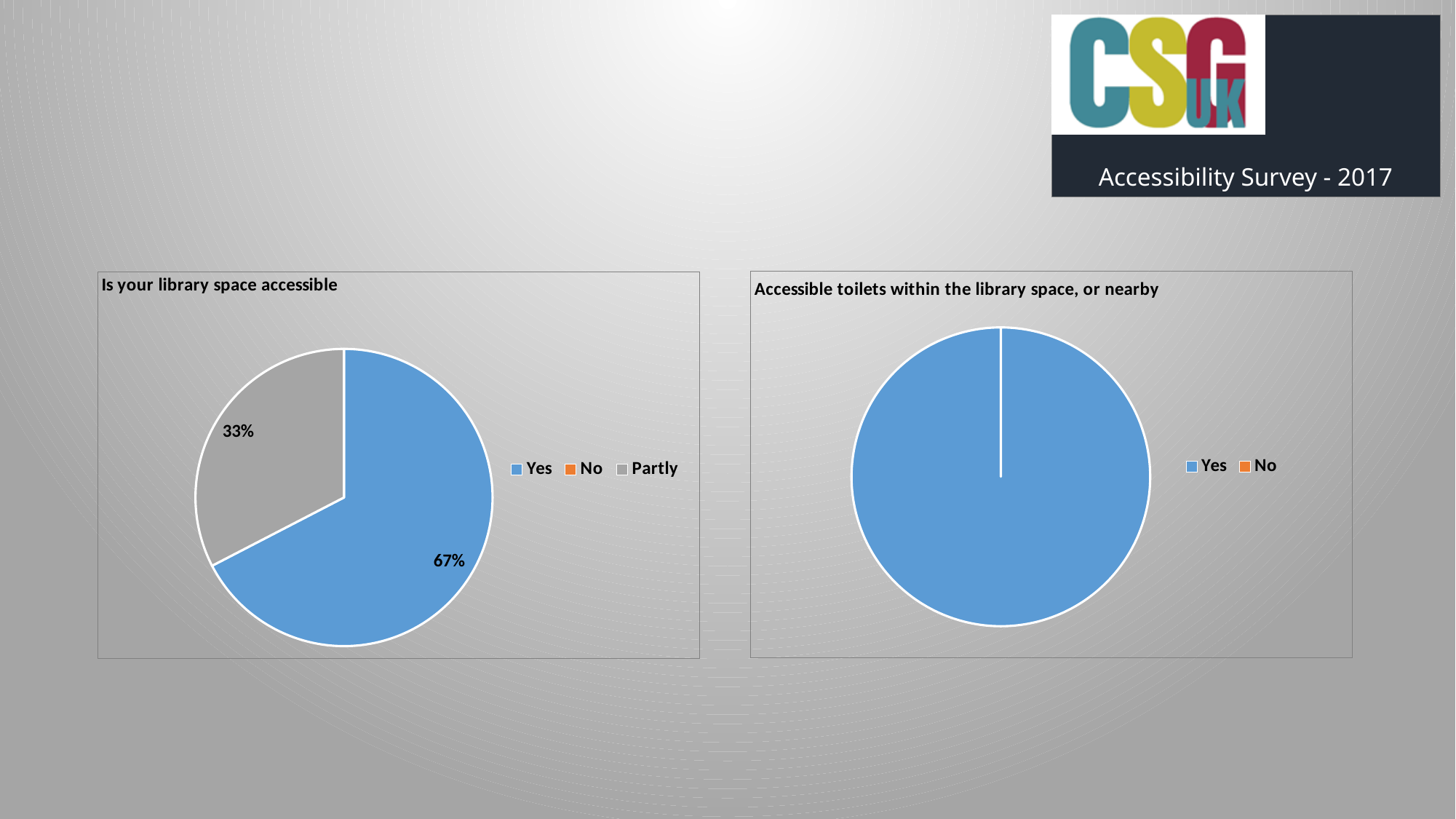
In the 'Is your library space accessible' chart, which is larger, Yes or Partly? Yes In the 'Is your library space accessible' chart, what percentage is shown for Partly? 33% In the 'Is your library space accessible' chart, what colour represents Partly? Grey In the 'Accessible toilets within the library space, or nearby' chart, which category fills the entire pie? Yes How many entries does the legend of the 'Is your library space accessible' chart list? 3 What is the title of the chart on the right of the slide? Accessible toilets within the library space, or nearby How many entries does the legend of the 'Accessible toilets within the library space, or nearby' chart list? 2 What kind of chart is 'Is your library space accessible'? Pie chart In the 'Is your library space accessible' chart, what percentage is shown for Yes? 67% What kind of chart is 'Accessible toilets within the library space, or nearby'? Pie chart In the 'Is your library space accessible' chart, which category has the largest slice? Yes In the 'Is your library space accessible' chart, what is the difference between the Yes and Partly percentages? 34%